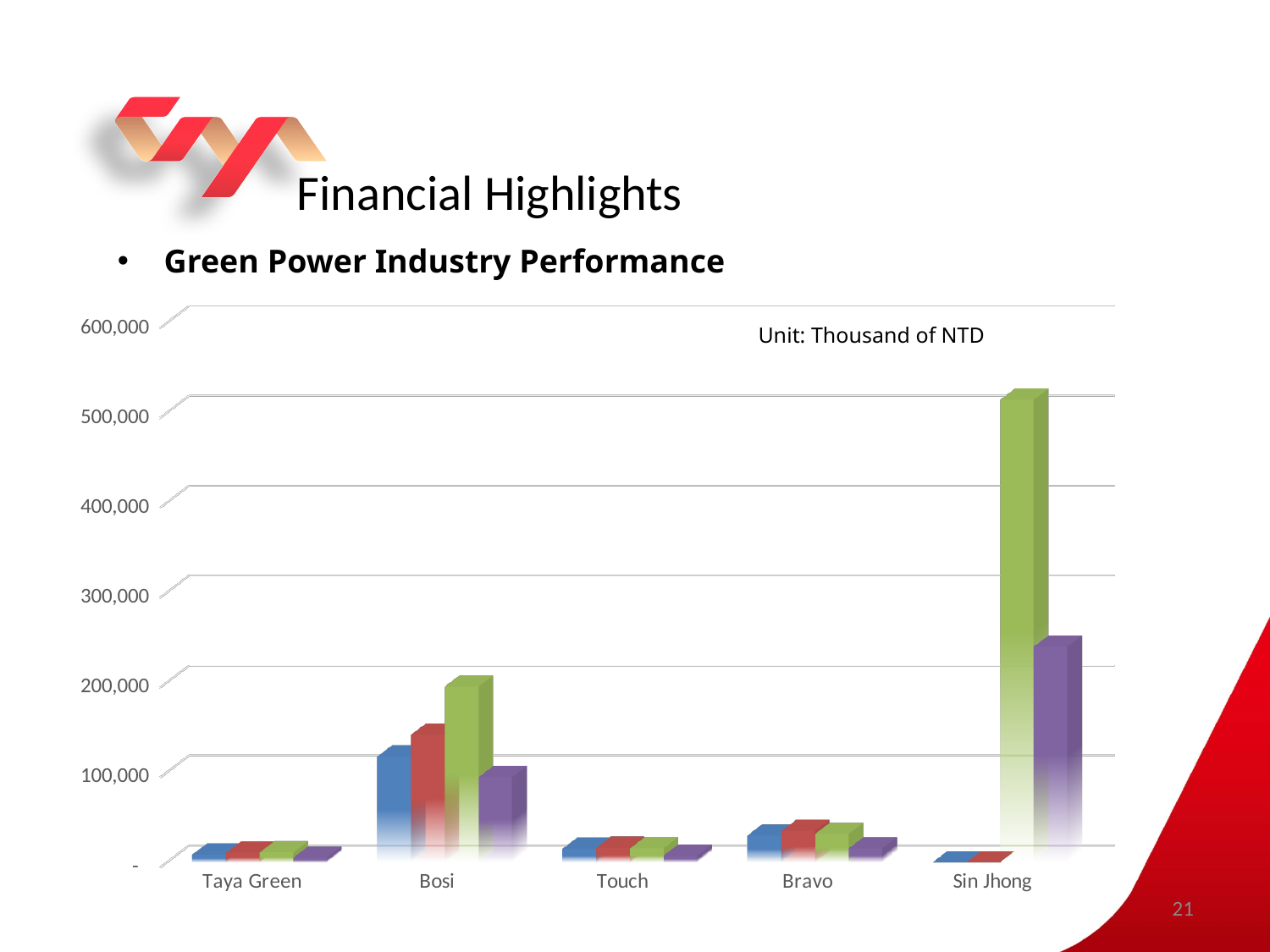
What kind of chart is shown on the slide? bar chart Which category has the tallest bar in the chart? Sin Jhong Which has the larger green bar, Sin Jhong or Bosi? Sin Jhong What unit does the chart state its values are in? Thousand of NTD Which has the larger green bar, Bosi or Bravo? Bosi Is the red bar for Bosi greater or less than 100,000? greater Is the tallest green bar for Sin Jhong greater or less than 500,000? greater Are all the bars for Touch greater or less than 100,000? less How many categories are shown on the x axis of the chart? 5